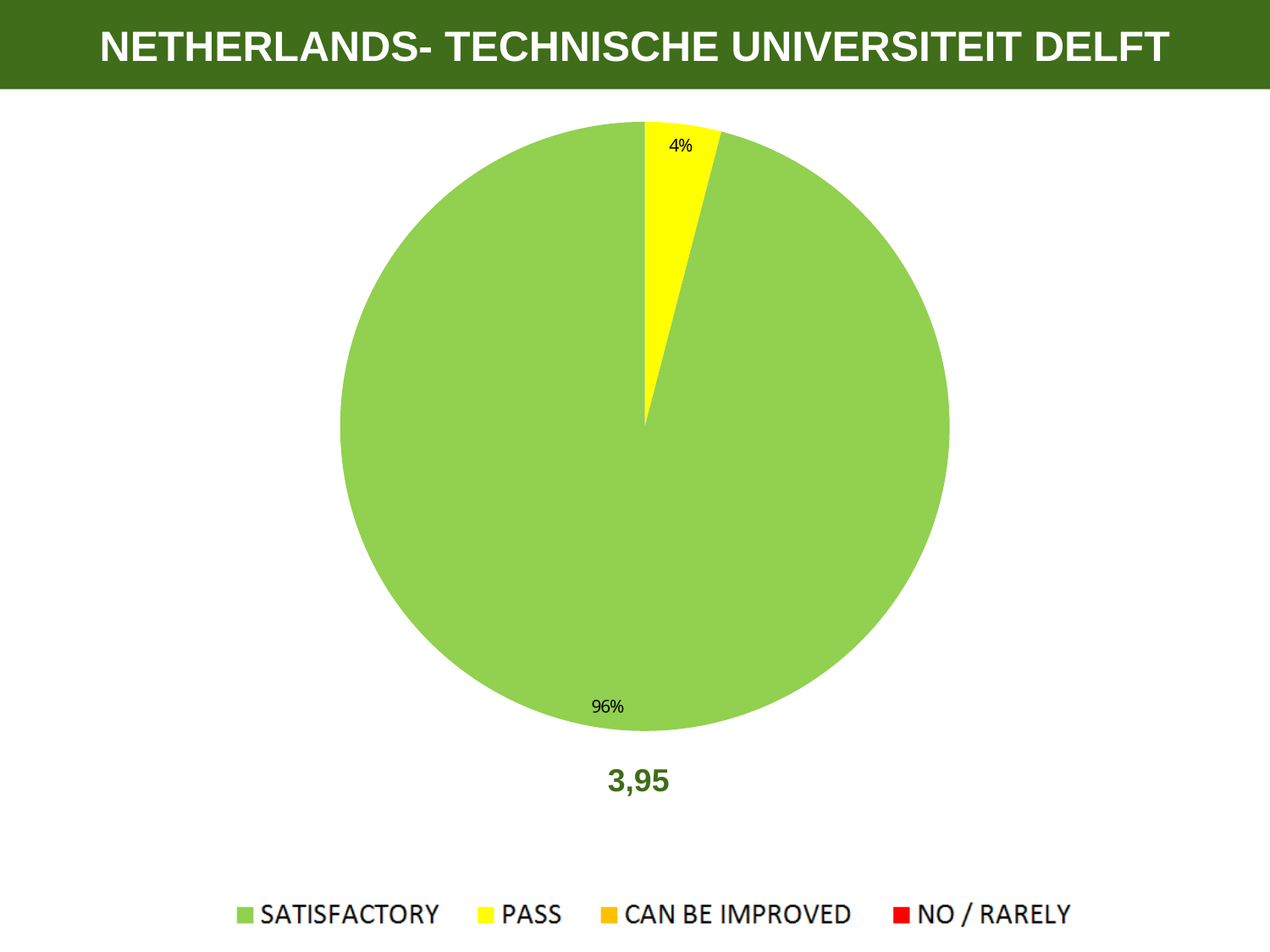
What kind of chart is shown on the slide? pie chart What share of the pie is labelled PASS? 4% What colour is the PASS slice in the pie chart? yellow Which of the two visible slices is larger, SATISFACTORY or PASS? SATISFACTORY What is the difference in percentage points between the SATISFACTORY and PASS slices? 92 How many categories does the legend list? 4 What share of the pie is labelled SATISFACTORY? 96% Is the share for SATISFACTORY greater or less than 50%? greater What number is printed below the pie chart? 3,95 What is the title of the slide? NETHERLANDS- TECHNISCHE UNIVERSITEIT DELFT Which category has the largest slice of the pie? SATISFACTORY